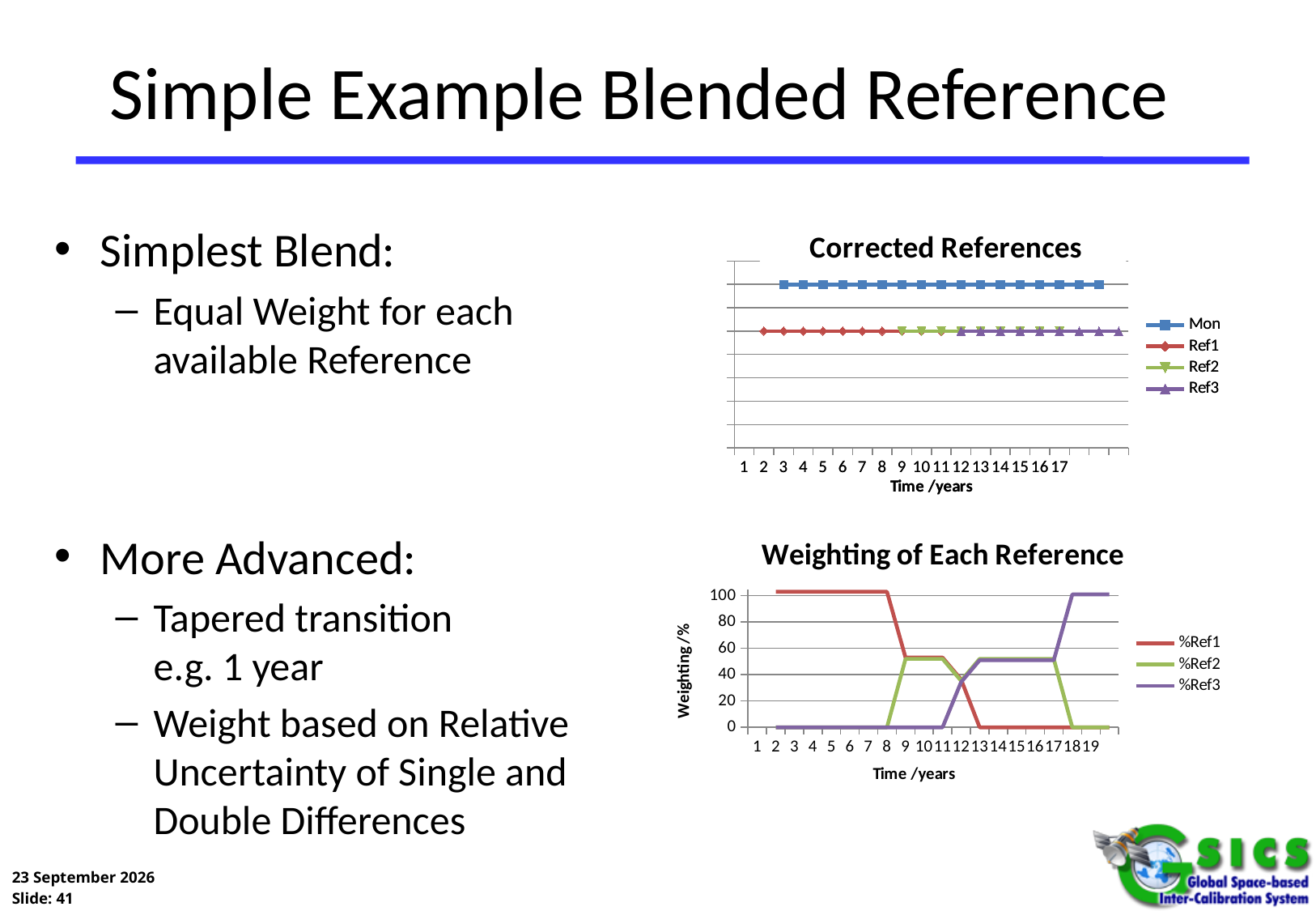
In the 'Weighting of Each Reference' chart, is the value of %Ref3 at year 15 greater or less than 80? less How many series does the legend of the 'Weighting of Each Reference' chart list? 3 In the 'Weighting of Each Reference' chart, does %Ref1 rise or fall overall along the time axis? fall How many series does the legend of the 'Corrected References' chart list? 4 In the 'Weighting of Each Reference' chart, which is larger at year 5, %Ref1 or %Ref2? %Ref1 What kind of chart is the 'Weighting of Each Reference' chart? line chart What is the y-axis title of the 'Weighting of Each Reference' chart? Weighting /% In the 'Weighting of Each Reference' chart, what is the value of %Ref2 at year 4? 0 In the 'Weighting of Each Reference' chart, is the value of %Ref1 at year 10 greater or less than 40? greater In the 'Weighting of Each Reference' chart, does %Ref3 rise or fall overall along the time axis? rise